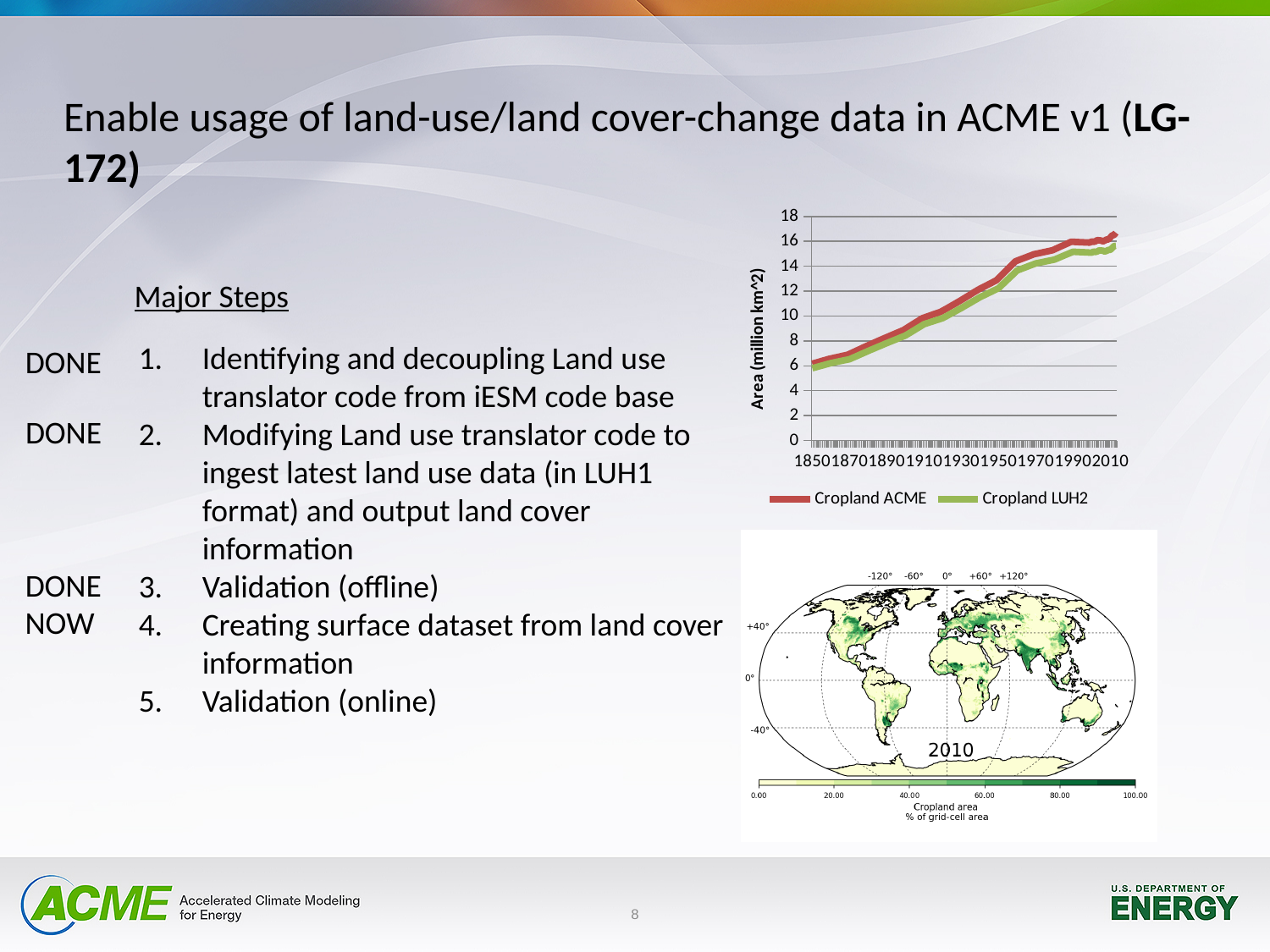
In the line chart, is the value for Cropland ACME in 1850 greater or less than 10? less In the line chart, do the cropland area values rise or fall from 1850 to 2010? rise What is the label of the y-axis of the line chart? Area (million km^2) In the line chart, is the value for Cropland ACME in 2010 greater or less than 14? greater How many series does the legend of the line chart list? 2 In the line chart, is the value for Cropland LUH2 in 2010 greater or less than 12? greater In the line chart, which series has the higher value in 2010, Cropland ACME or Cropland LUH2? Cropland ACME What is the highest value shown on the y-axis of the line chart? 18 What kind of chart is the chart in the upper right of the slide? line chart In the line chart, which colour is used for the Cropland LUH2 series? green